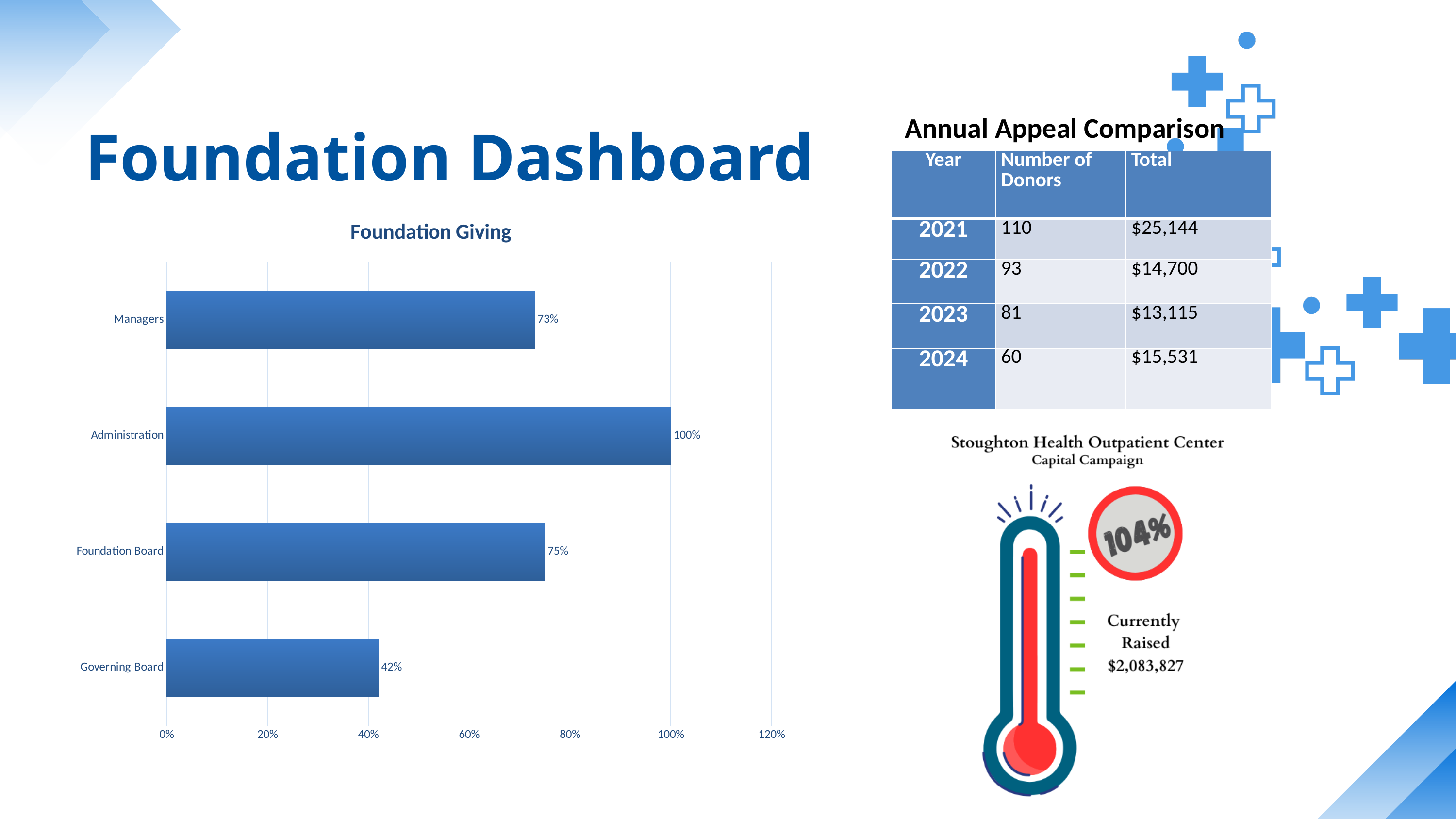
In the Foundation Giving chart, which category has the highest value? Administration In the Foundation Giving chart, what is the value for Administration? 100% In the Foundation Giving chart, what is the value for Foundation Board? 75% In the Foundation Giving chart, which is larger, the value for Managers or the value for Governing Board? Managers In the Foundation Giving chart, which category has the lowest value? Governing Board What is the title of the chart on the left side of the slide? Foundation Giving How many categories are shown in the Foundation Giving chart? 4 In the Foundation Giving chart, what is the difference between the values for Administration and Governing Board? 58% In the Foundation Giving chart, what is the value for Managers? 73% In the Foundation Giving chart, what is the value for Governing Board? 42% In the Foundation Giving chart, is the value for Governing Board greater or less than 60%? less What kind of chart is the Foundation Giving chart? bar chart